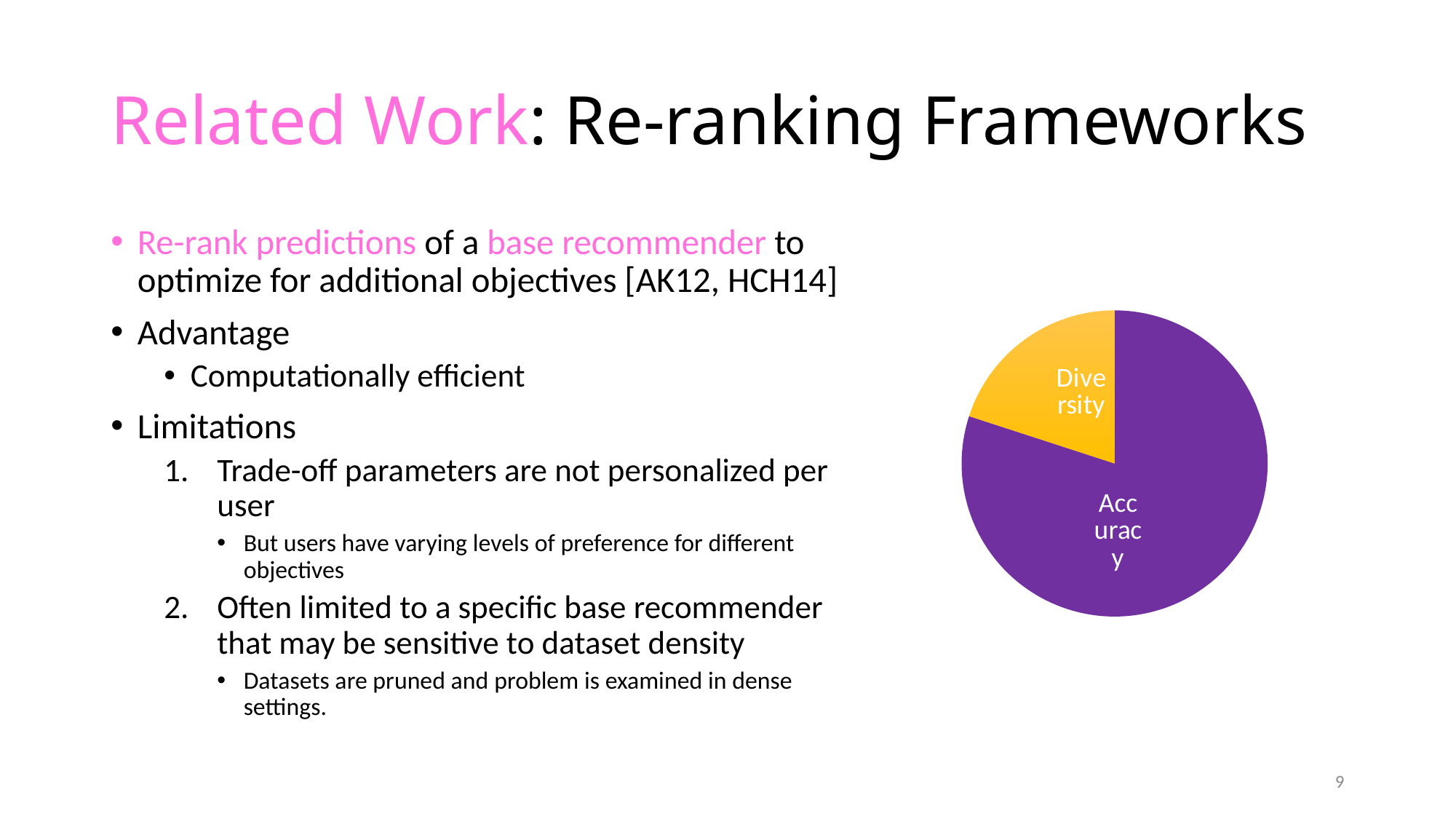
Which slice of the pie chart is the smallest? Diversity What colour is the Accuracy slice in the pie chart? purple Which slice of the pie chart is the largest? Accuracy How many slices does the pie chart have? 2 What colour is the Diversity slice in the pie chart? yellow Which slice is larger in the pie chart, Accuracy or Diversity? Accuracy What kind of chart is shown on the slide? pie chart